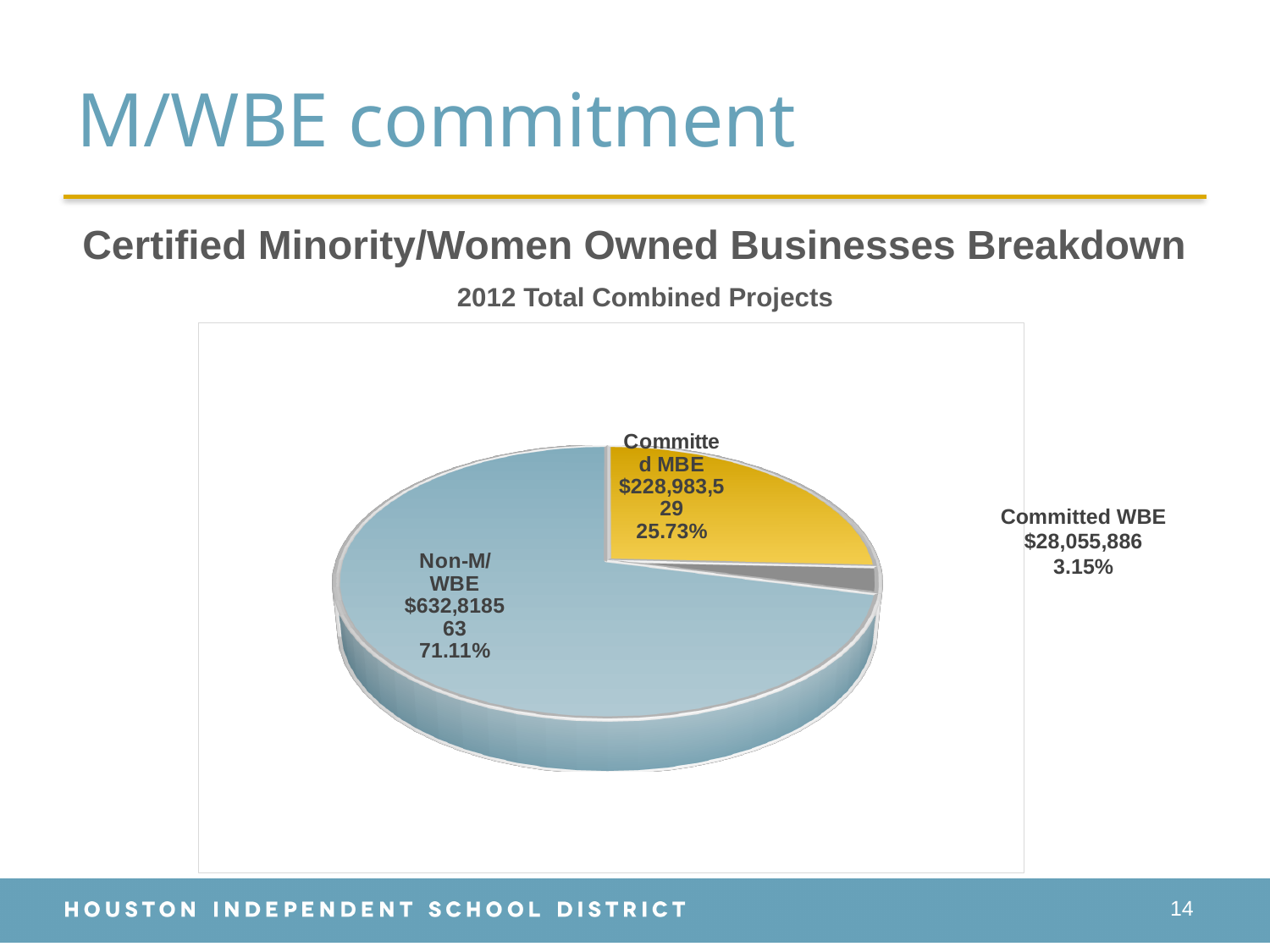
What is the dollar value for Committed WBE? $28,055,886 Which category has the largest share of the pie? Non-M/WBE How many slices does the pie chart have? 3 What kind of chart is shown on the slide? Pie chart What percentage share does Committed WBE have? 3.15% What is the dollar value for Committed MBE? $228,983,529 What is the title of the chart? 2012 Total Combined Projects What percentage share does Non-M/WBE have? 71.11% What is the difference in percentage points between the Non-M/WBE share and the Committed MBE share? 45.38% Which category has the smallest share of the pie? Committed WBE Which is larger, the share for Committed MBE or Committed WBE? Committed MBE What percentage share does Committed MBE have? 25.73%